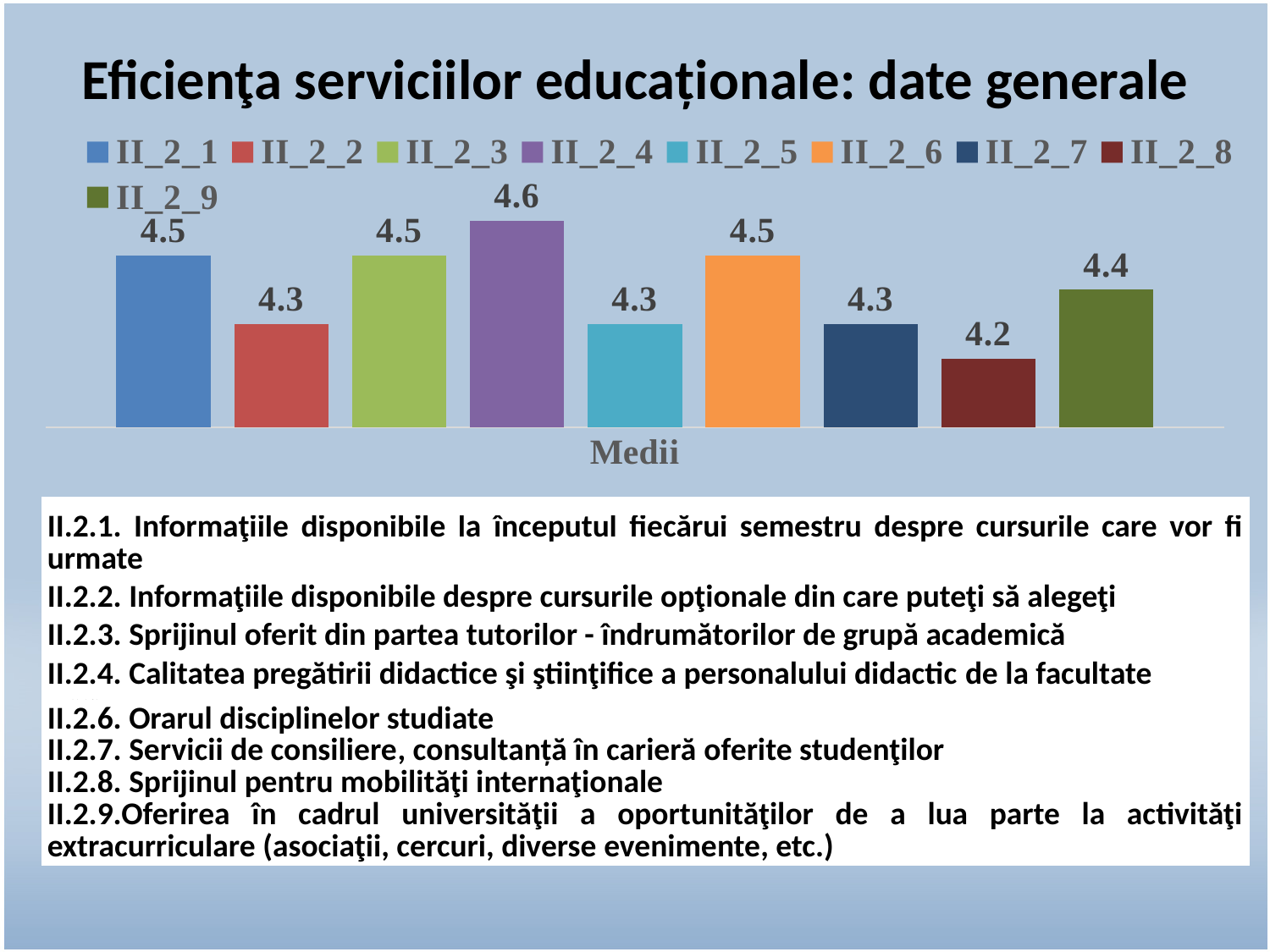
What is the value for II_2_8? 4.2 Which is larger, the value for II_2_6 or the value for II_2_7? II_2_6 How many series does the legend list? 9 What is the difference between the values for II_2_4 and II_2_8? 0.4 What is the category label shown on the x axis of the chart? Medii What is the difference between the values for II_2_1 and II_2_9? 0.1 What is the value for II_2_2? 4.3 What kind of chart is shown on the slide? Bar chart Which series has the highest value? II_2_4 What is the value for II_2_9? 4.4 Which series has the lowest value? II_2_8 What is the value for II_2_4? 4.6